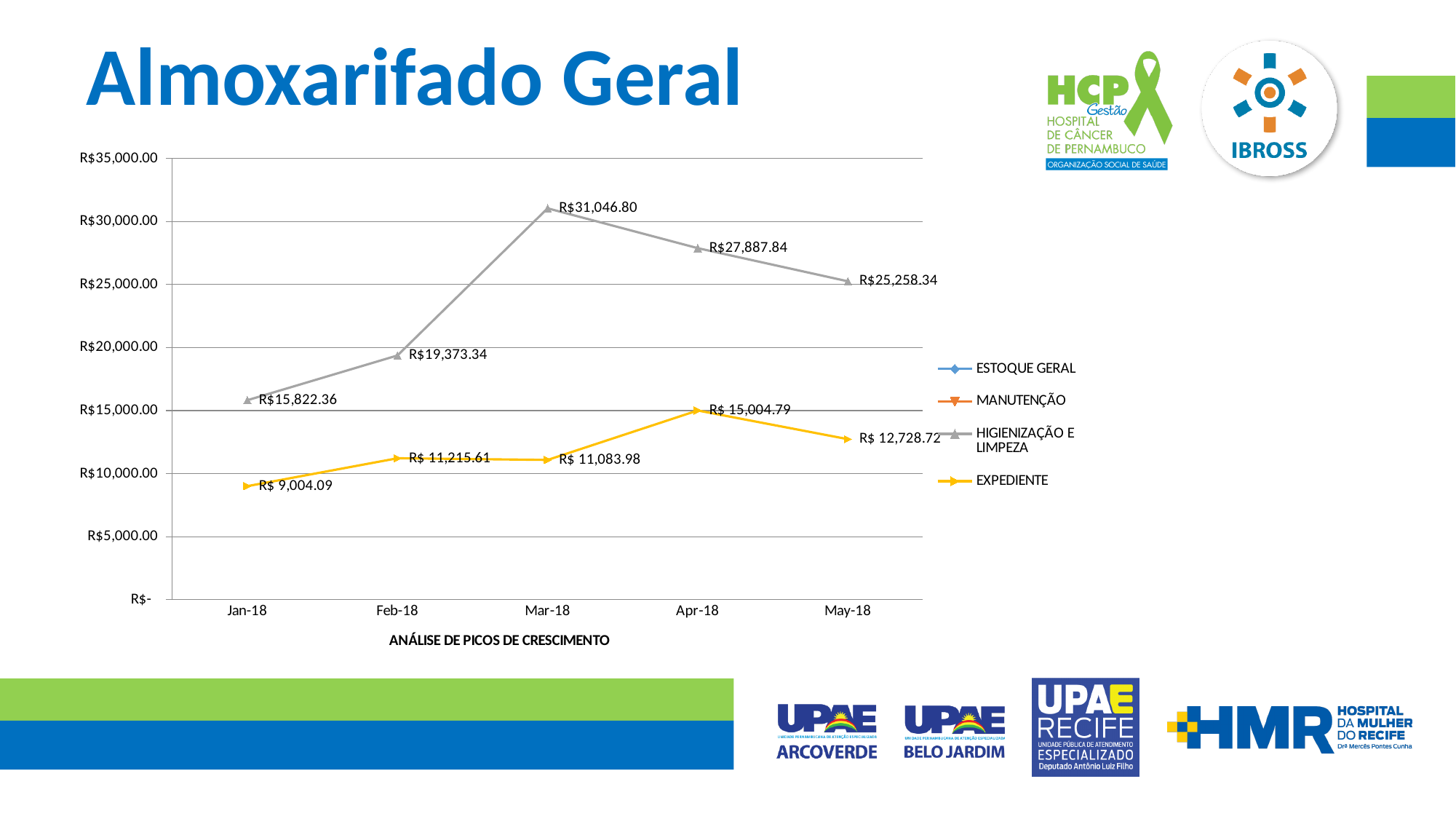
Which is larger: EXPEDIENTE in Apr-18 or EXPEDIENTE in May-18? Apr-18 What is the value for EXPEDIENTE in Jan-18? R$ 9,004.09 How many months are shown on the x axis? 5 In which month is HIGIENIZAÇÃO E LIMPEZA highest? Mar-18 What is the difference between HIGIENIZAÇÃO E LIMPEZA and EXPEDIENTE in Mar-18? R$19,962.82 How many series does the legend list? 4 What is the value for HIGIENIZAÇÃO E LIMPEZA in Mar-18? R$31,046.80 What is the value for EXPEDIENTE in May-18? R$ 12,728.72 What type of chart is shown on the slide? line chart Does HIGIENIZAÇÃO E LIMPEZA rise or fall from Mar-18 to May-18? fall In which month is EXPEDIENTE lowest? Jan-18 What is the text shown below the x axis of the chart? ANÁLISE DE PICOS DE CRESCIMENTO